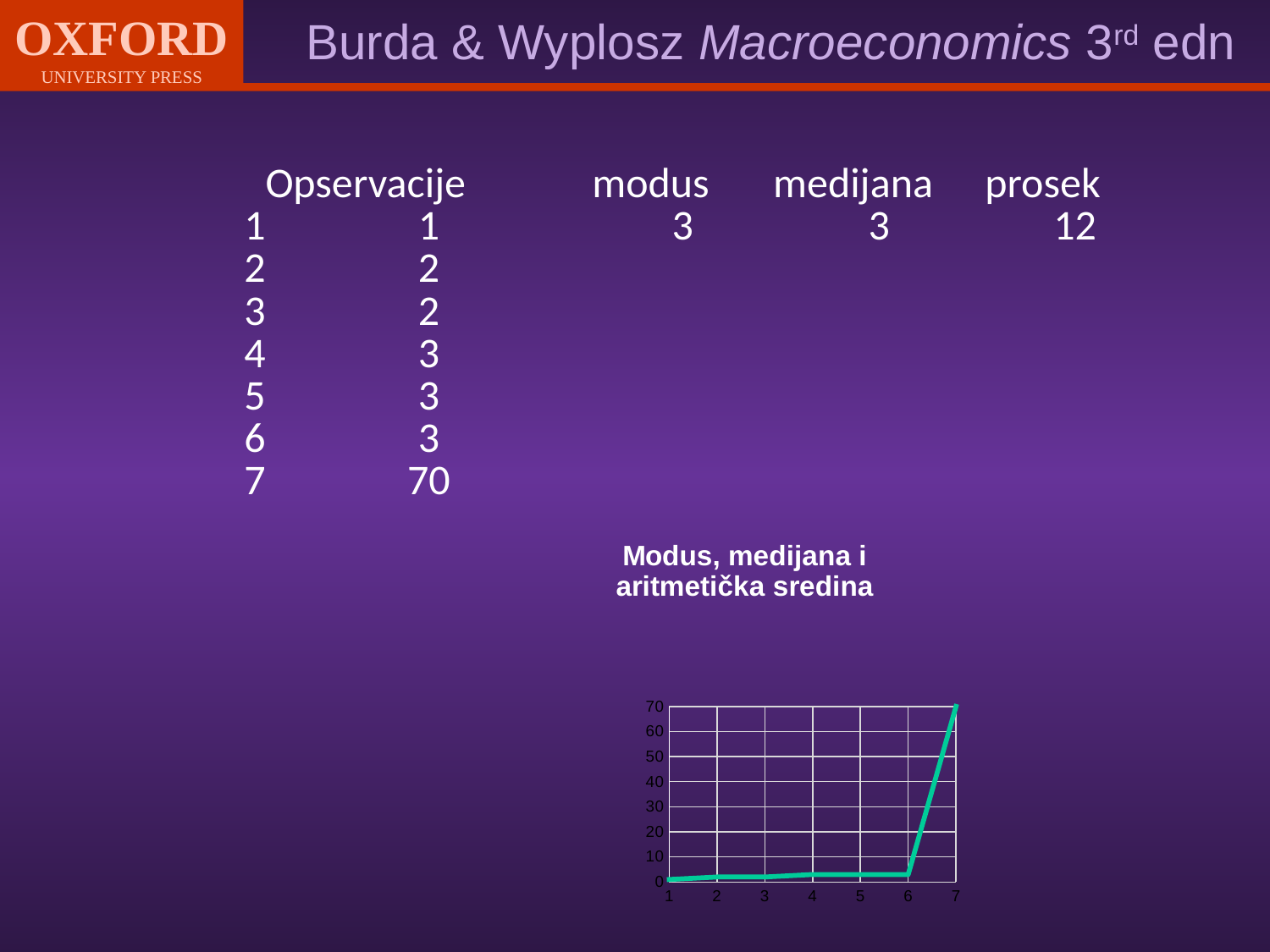
How many points are plotted along the x axis of the chart? 7 Is the value of the line at x = 4 greater or less than 20? less Which has the larger value on the line, x = 6 or x = 7? 7 What colour is the plotted line in the chart? green Is the value of the line at x = 6 greater or less than 10? less What is the title written above the chart? Modus, medijana i aritmetička sredina What kind of chart is shown at the bottom of the slide? line chart At which x-axis value does the line reach its highest point? 7 What is the highest value shown on the chart's y axis? 70 What is the value of the line at x = 7? 70 Do the values of the line rise or fall from x = 1 to x = 7? rise Is the value of the line at x = 7 greater or less than 60? greater